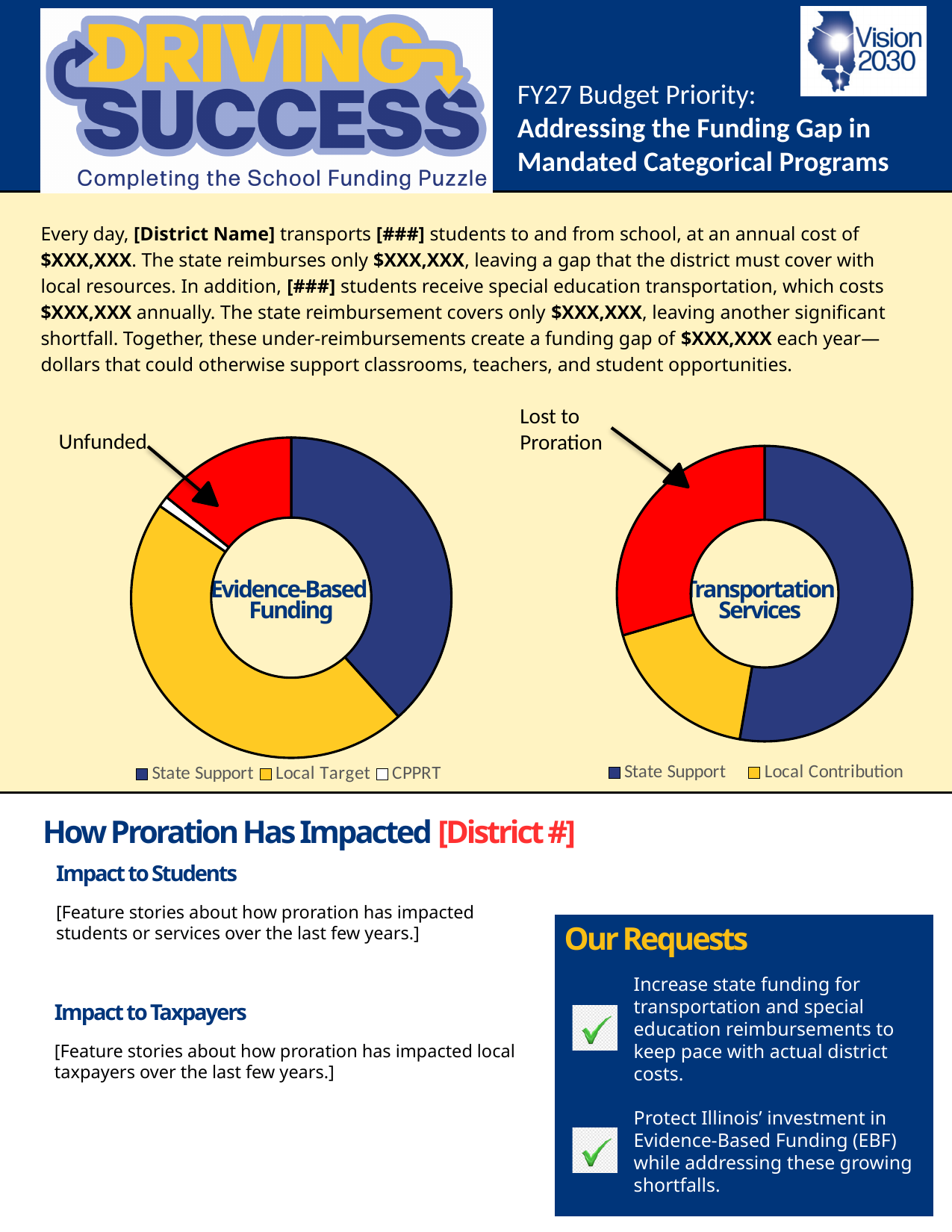
What colour is the Local Target slice in the Evidence-Based Funding chart? Yellow How many entries does the legend of the Transportation Services chart list? 2 In the Transportation Services chart, which slice is larger: Lost to Proration or Local Contribution? Lost to Proration What kind of chart is the Evidence-Based Funding chart? Donut (pie) chart In the Evidence-Based Funding chart, which slice is larger: Unfunded or CPPRT? Unfunded What kind of chart is the Transportation Services chart? Donut (pie) chart In the Evidence-Based Funding chart, which legend category has the smallest slice? CPPRT How many entries does the legend of the Evidence-Based Funding chart list? 3 What label does the arrow point to on the red slice of the Transportation Services chart? Lost to Proration In the Transportation Services chart, which slice is the largest? State Support In the Transportation Services chart, which legend category has the smallest slice? Local Contribution In the Evidence-Based Funding chart, which slice is larger: State Support or Unfunded? State Support